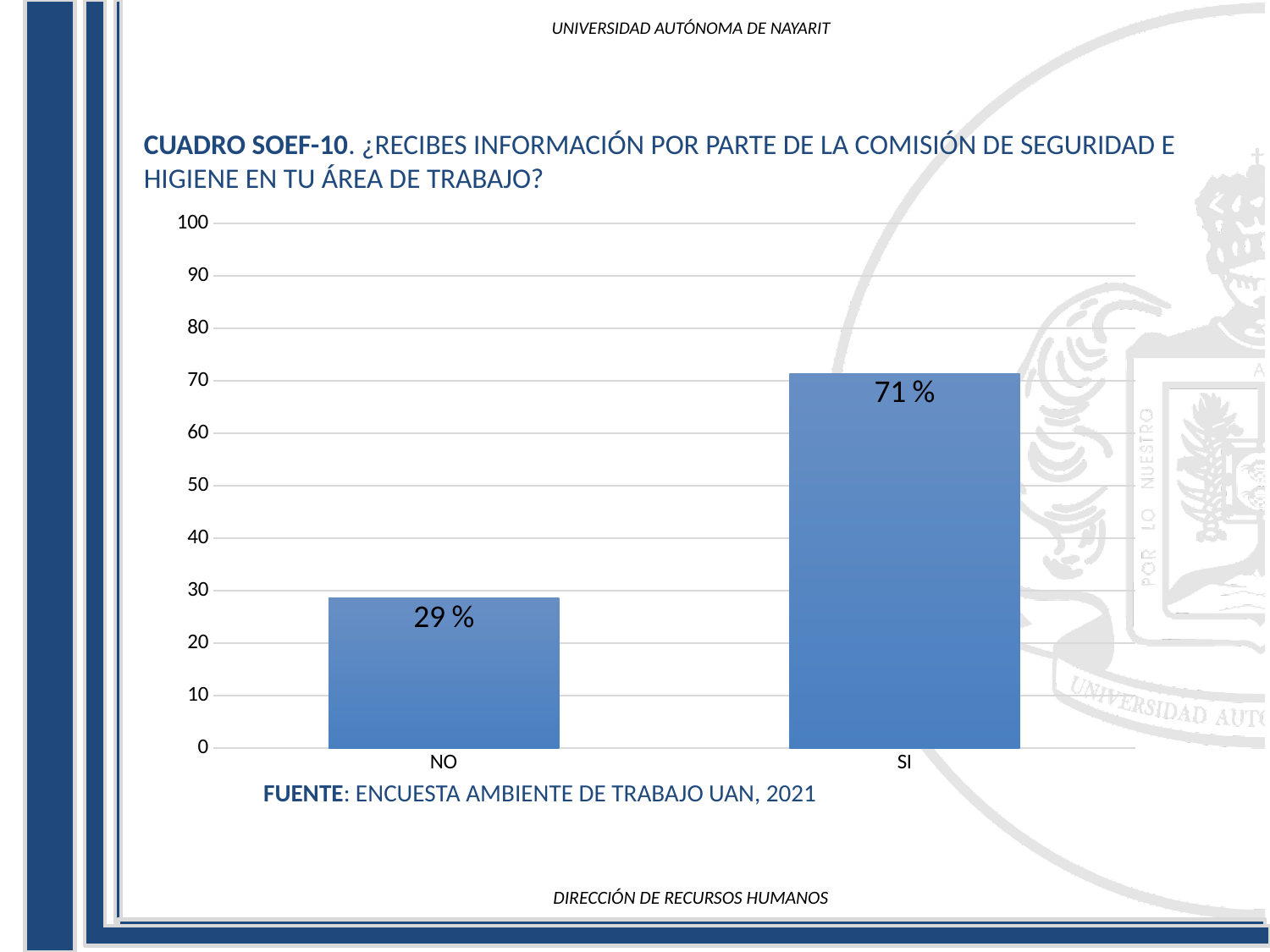
Which category has the lowest value? NO What source is cited below the chart? ENCUESTA AMBIENTE DE TRABAJO UAN, 2021 Which category has the highest value? SI Is the value for NO greater or less than 40? less What is the value for NO? 29 % What is the value for SI? 71 % Which is larger, the value for NO or the value for SI? SI What is the difference between the values for SI and NO? 42 % What kind of chart is shown on the slide? bar chart What is the highest value shown on the y axis? 100 Is the value for SI greater or less than 60? greater How many categories are shown on the x axis? 2